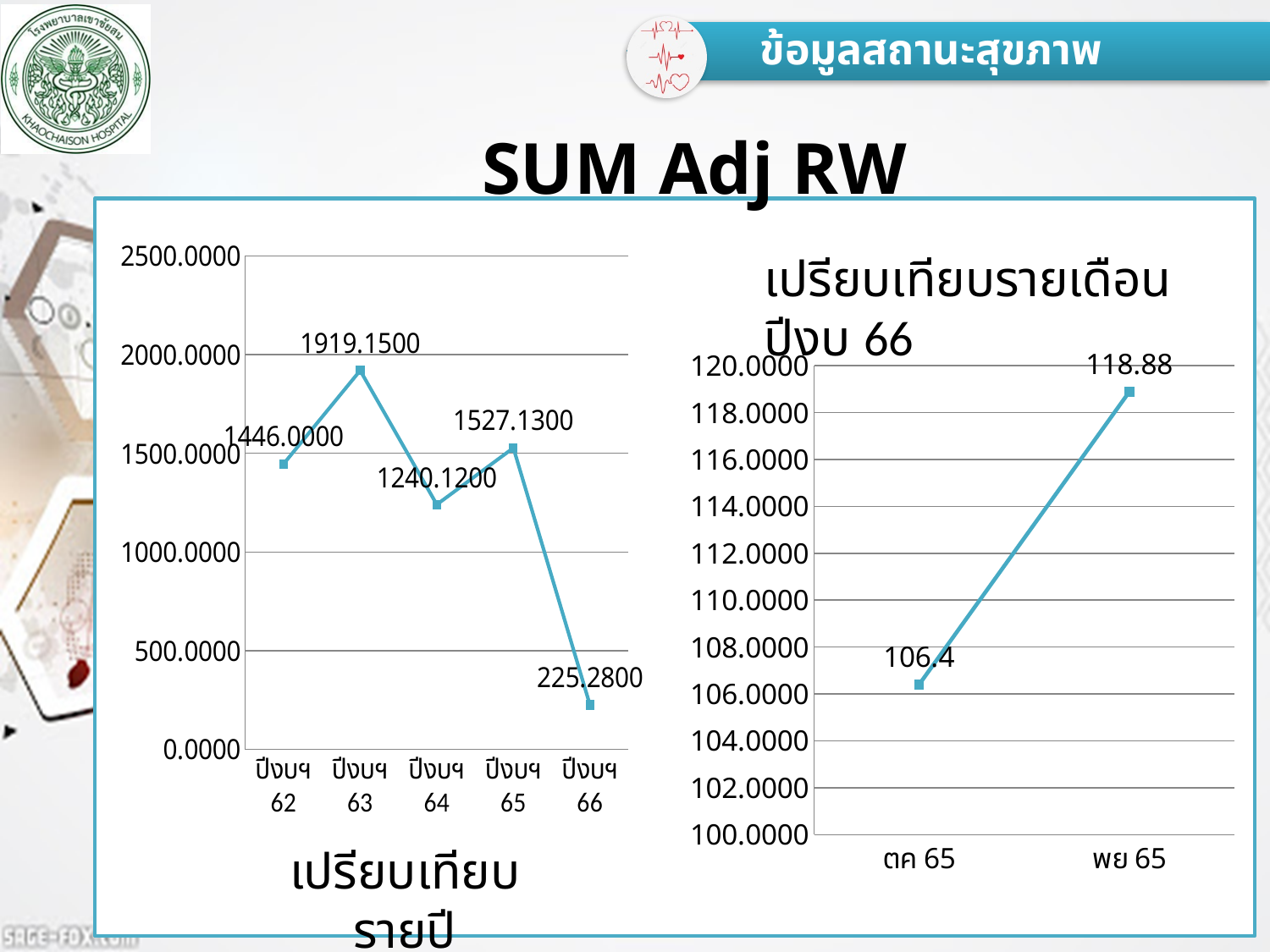
In the right chart (เปรียบเทียบรายเดือน ปีงบ 66), what is the value for พย 65? 118.88 In the left chart (เปรียบเทียบรายปี), what is the difference between the values for ปีงบฯ 63 and ปีงบฯ 64? 679.0300 What kind of chart is the left chart (เปรียบเทียบรายปี)? Line chart In the right chart (เปรียบเทียบรายเดือน ปีงบ 66), what is the value for ตค 65? 106.4 In the left chart (เปรียบเทียบรายปี), which year has the highest value? ปีงบฯ 63 In the left chart (เปรียบเทียบรายปี), how many years are plotted? 5 In the right chart (เปรียบเทียบรายเดือน ปีงบ 66), does the value rise or fall from ตค 65 to พย 65? Rise In the right chart (เปรียบเทียบรายเดือน ปีงบ 66), what is the difference between the values for พย 65 and ตค 65? 12.48 In the left chart (เปรียบเทียบรายปี), which is larger: the value for ปีงบฯ 62 or ปีงบฯ 65? ปีงบฯ 65 In the left chart (เปรียบเทียบรายปี), what is the value for ปีงบฯ 63? 1919.1500 In the left chart (เปรียบเทียบรายปี), what is the value for ปีงบฯ 66? 225.2800 In the left chart (เปรียบเทียบรายปี), which year has the lowest value? ปีงบฯ 66